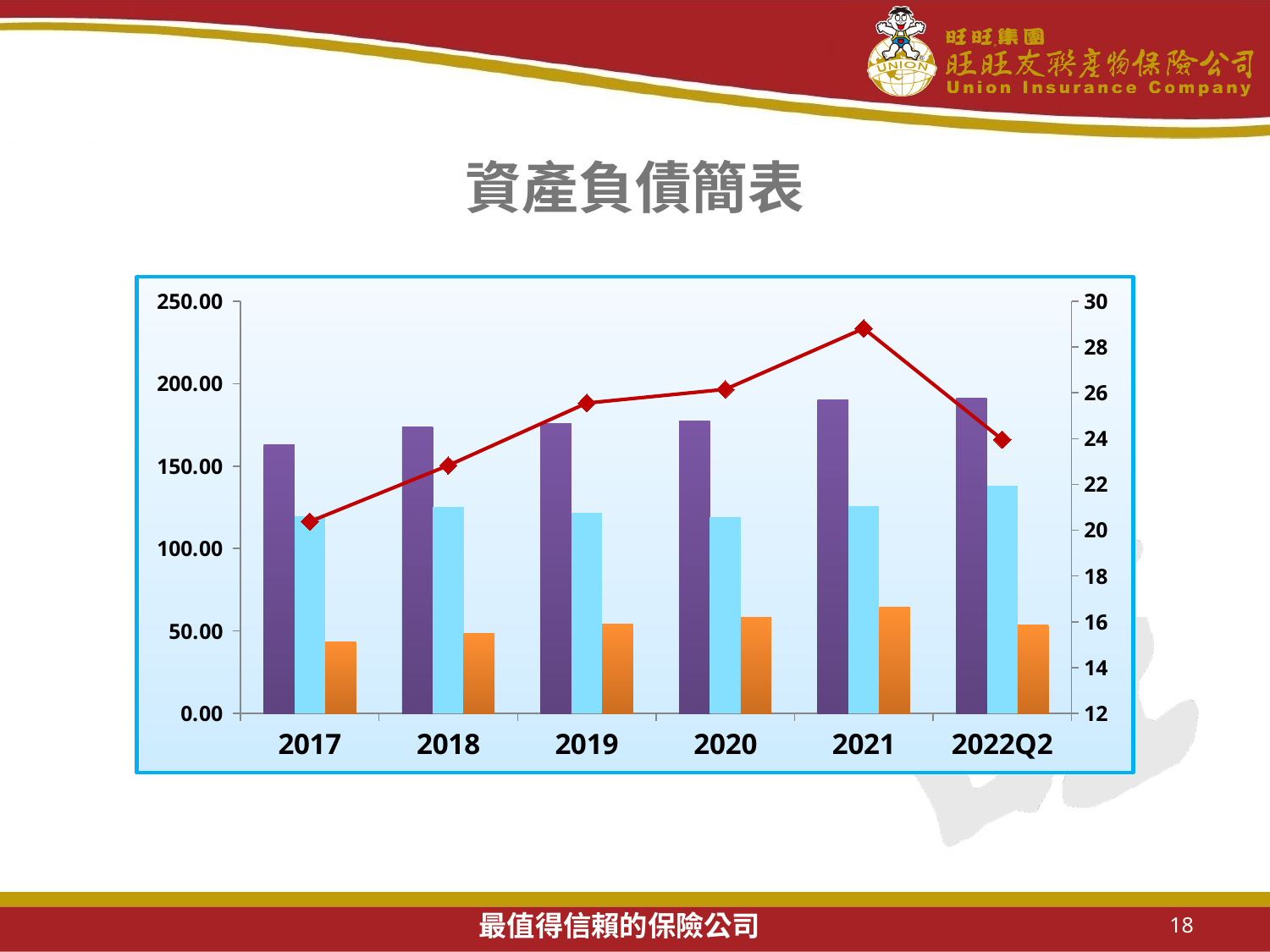
Which category has the highest light blue bar? 2022Q2 Is the purple bar for 2017 greater or less than 150.00? greater Which category has the lowest purple bar? 2017 How many bars are plotted for each year category in the chart? 3 Which category has the highest orange bar? 2021 Is the red line value for 2021 greater or less than 28 on the right axis? greater What kind of chart is shown on the slide? Bar chart combined with a line Which category has the lowest orange bar? 2017 Is the orange bar for 2017 greater or less than 50.00? less At which category does the red line reach its highest point? 2021 Does the red line rise or fall from 2021 to 2022Q2? Fall How many categories are shown on the x axis of the chart? 6